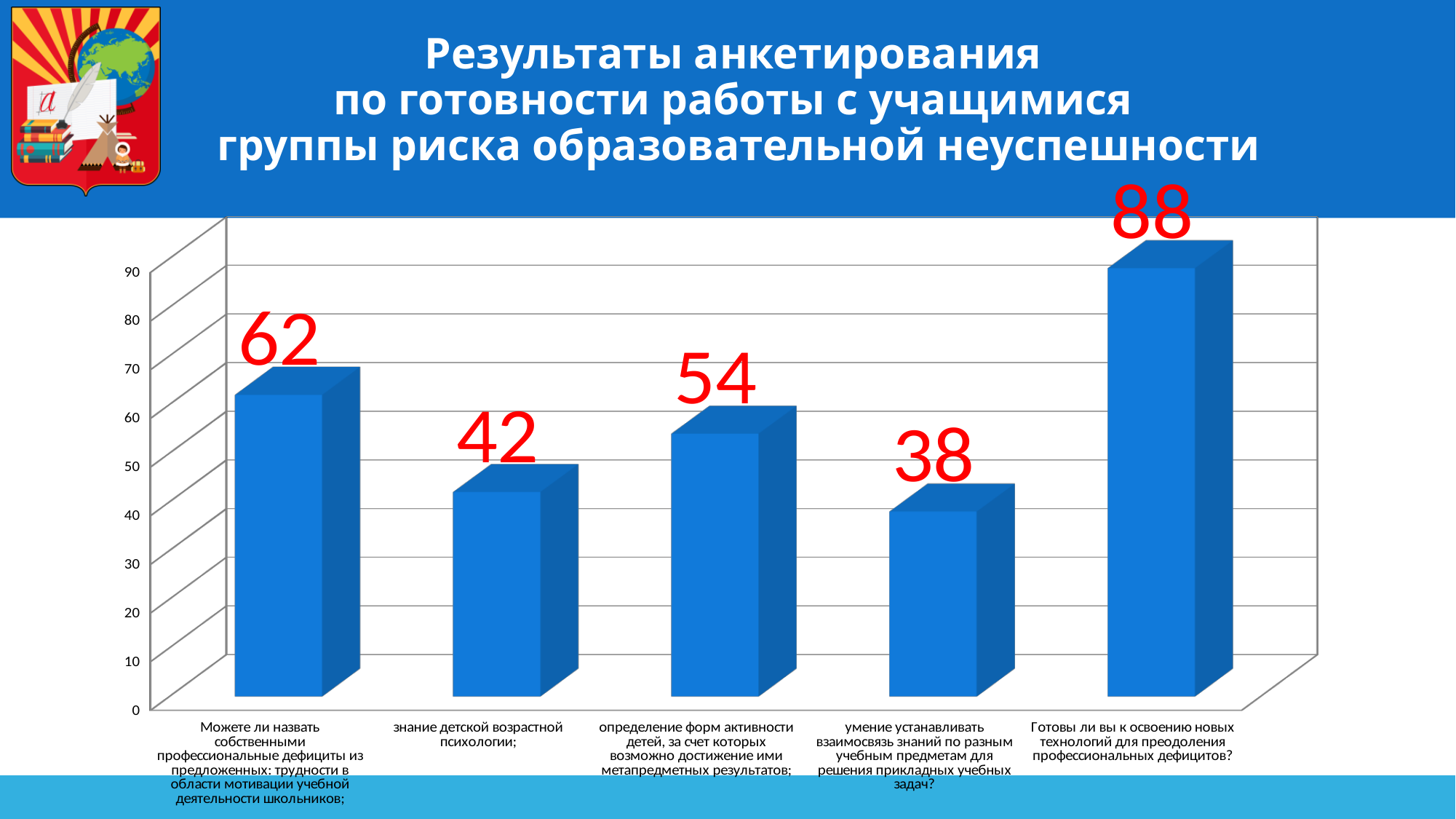
Which category has the lowest value? умение устанавливать взаимосвязь знаний по разным учебным предметам для решения прикладных учебных задач? What is the value for "умение устанавливать взаимосвязь знаний по разным учебным предметам для решения прикладных учебных задач?"? 38 Is the value for "Можете ли назвать собственные профессиональные дефициты из предложенных" greater or less than 50? greater What is the highest value printed on the chart? 88 Which is larger: the value for "определение форм активности детей" or the value for "знание детской возрастной психологии"? определение форм активности детей Which category has the highest value? Готовы ли вы к освоению новых технологий для преодоления профессиональных дефицитов? How many categories are shown in the chart? 5 What is the difference between the value for "Готовы ли вы к освоению новых технологий для преодоления профессиональных дефицитов?" and the value for "знание детской возрастной психологии"? 46 What is the value for "Готовы ли вы к освоению новых технологий для преодоления профессиональных дефицитов?"? 88 What is the difference between the value for "Можете ли назвать собственные профессиональные дефициты из предложенных" and the value for "определение форм активности детей"? 8 What is the value for "знание детской возрастной психологии"? 42 What kind of chart is shown on the slide? bar chart